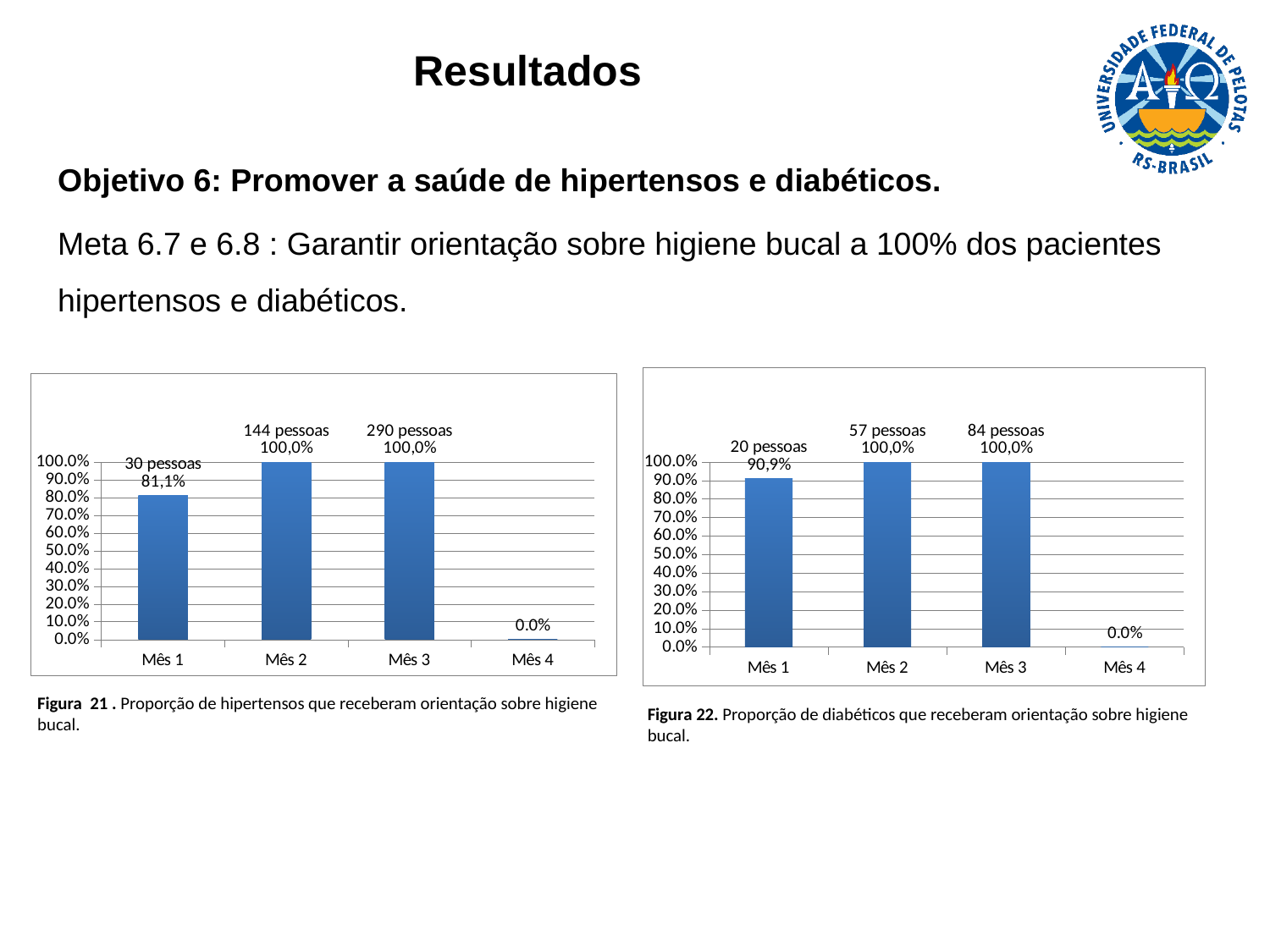
In the right chart (Figura 22, diabéticos), is the value for Mês 1 greater or less than Mês 2? less According to the caption, what does the left chart (Figura 21) show? Proporção de hipertensos que receberam orientação sobre higiene bucal In the right chart (Figura 22, diabéticos), what percentage is shown for Mês 1? 90,9% How many months (categories) are shown on the x axis of the left chart (Figura 21)? 4 What type of chart is the right chart (Figura 22)? bar chart In the right chart (Figura 22, diabéticos), how many people are indicated for Mês 2? 57 pessoas In the left chart (Figura 21, hipertensos), how many people are indicated for Mês 3? 290 pessoas In the right chart (Figura 22, diabéticos), what is the value for Mês 4? 0.0% In the left chart (Figura 21, hipertensos), what percentage is shown for Mês 1? 81,1% In the left chart (Figura 21, hipertensos), which month has the lowest value? Mês 4 In the right chart (Figura 22, diabéticos), what is the difference in percentage points between Mês 2 and Mês 1? 9,1 In the left chart (Figura 21, hipertensos), is the value for Mês 1 greater or less than 90.0%? less